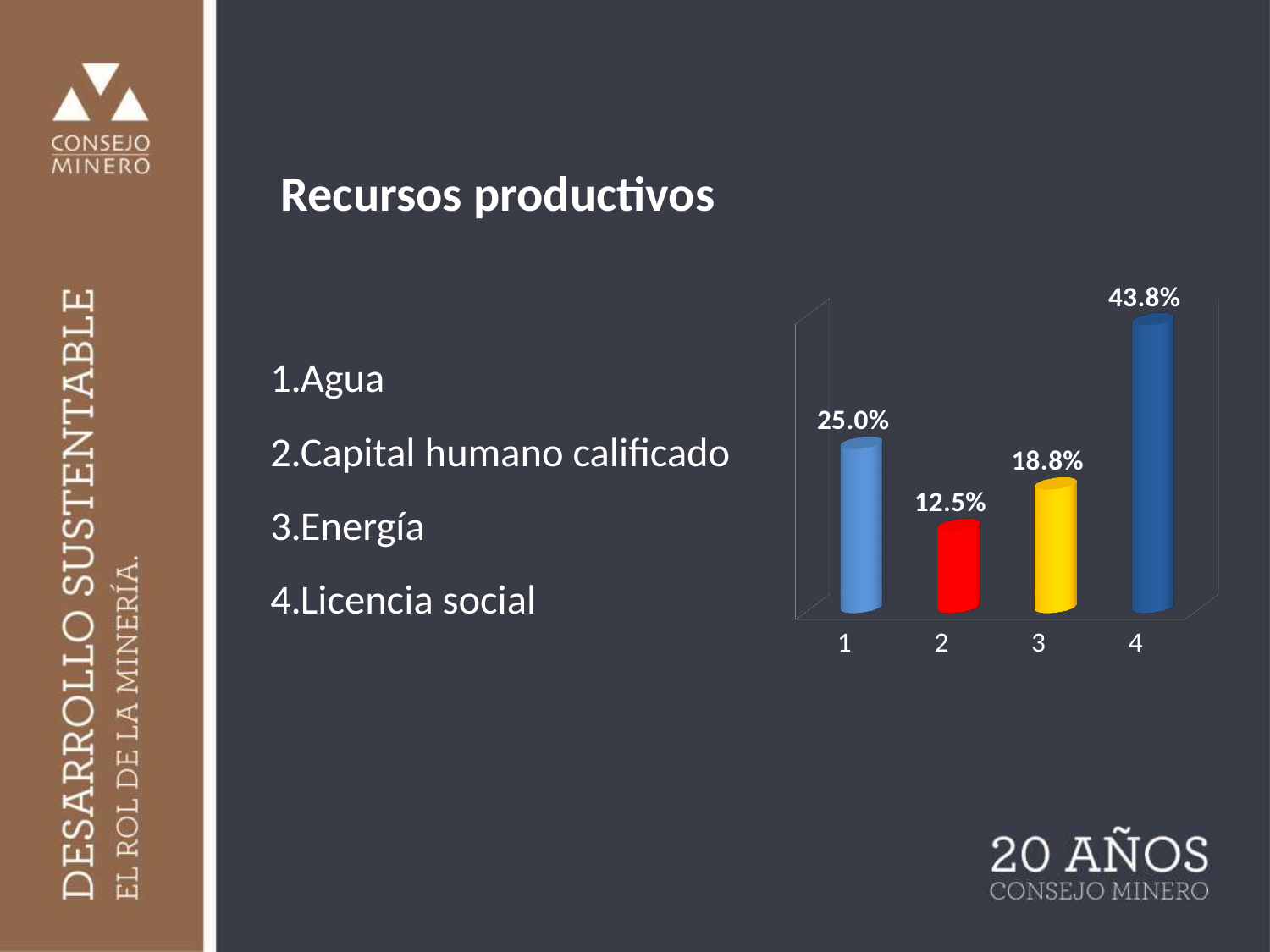
How many bars are plotted in the chart? 4 Which is larger, the value for category 1 or the value for category 3? 1 What is the difference between the values for category 4 and category 1? 18.8% What is the difference between the values for category 3 and category 2? 6.3% What is the value for category 4 in the chart? 43.8% Which category has the highest value in the chart? 4 What is the value for category 2 in the chart? 12.5% Which category has the lowest value in the chart? 2 What is the value for category 3 in the chart? 18.8% What colour is the bar for category 2? red What kind of chart is shown on the slide? bar chart What is the value for category 1 in the chart? 25.0%